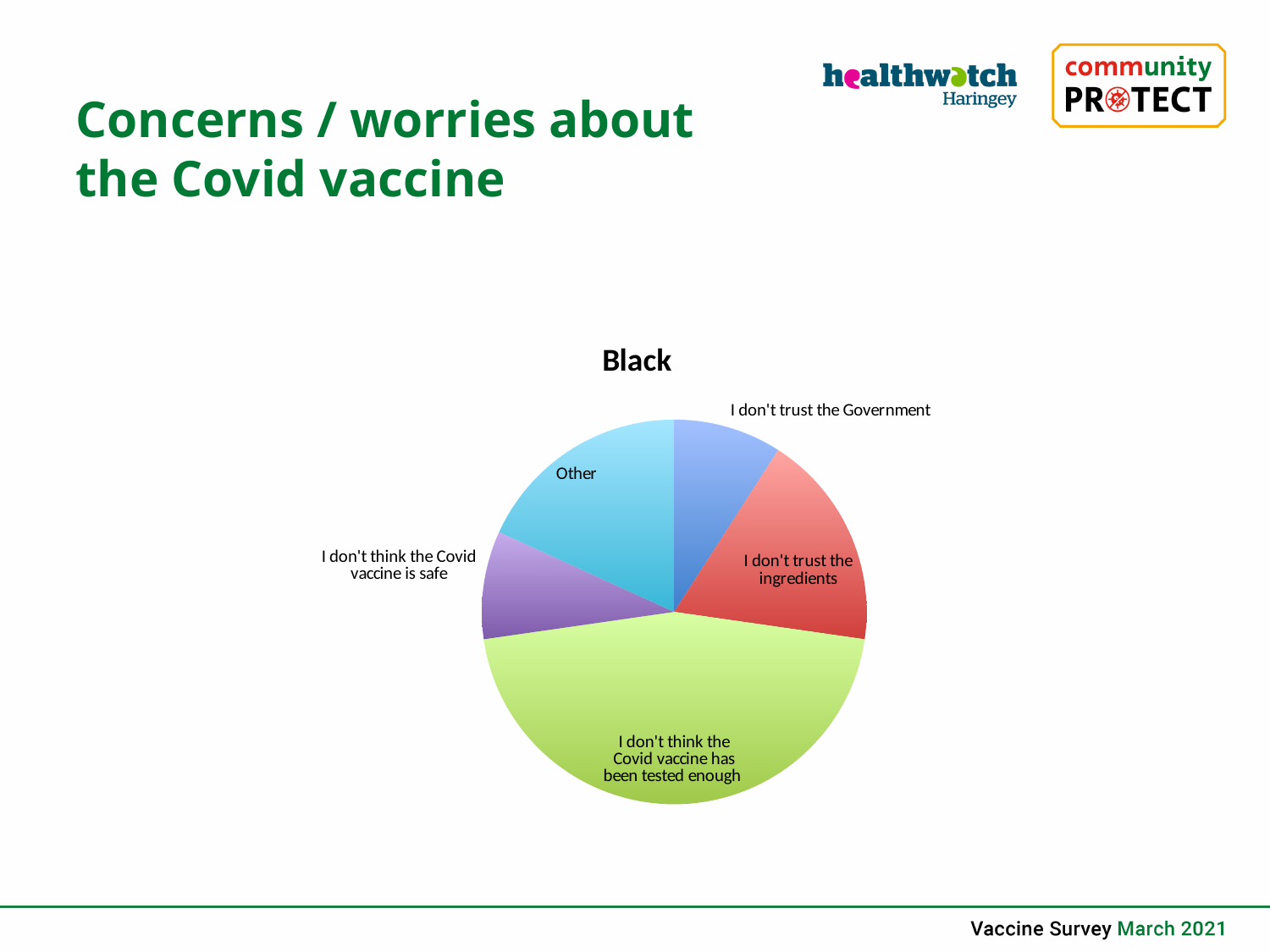
What kind of chart is shown on the slide? Pie chart How many slices does the pie chart have? 5 What is the title of the pie chart? Black Which slice is larger: "I don't trust the ingredients" or "I don't think the Covid vaccine is safe"? I don't trust the ingredients Which slice is larger: "I don't think the Covid vaccine has been tested enough" or "I don't trust the ingredients"? I don't think the Covid vaccine has been tested enough Which slice is larger: "Other" or "I don't trust the Government"? Other Which concern has the largest slice of the pie chart? I don't think the Covid vaccine has been tested enough What colour is the slice for "I don't think the Covid vaccine has been tested enough"? Green